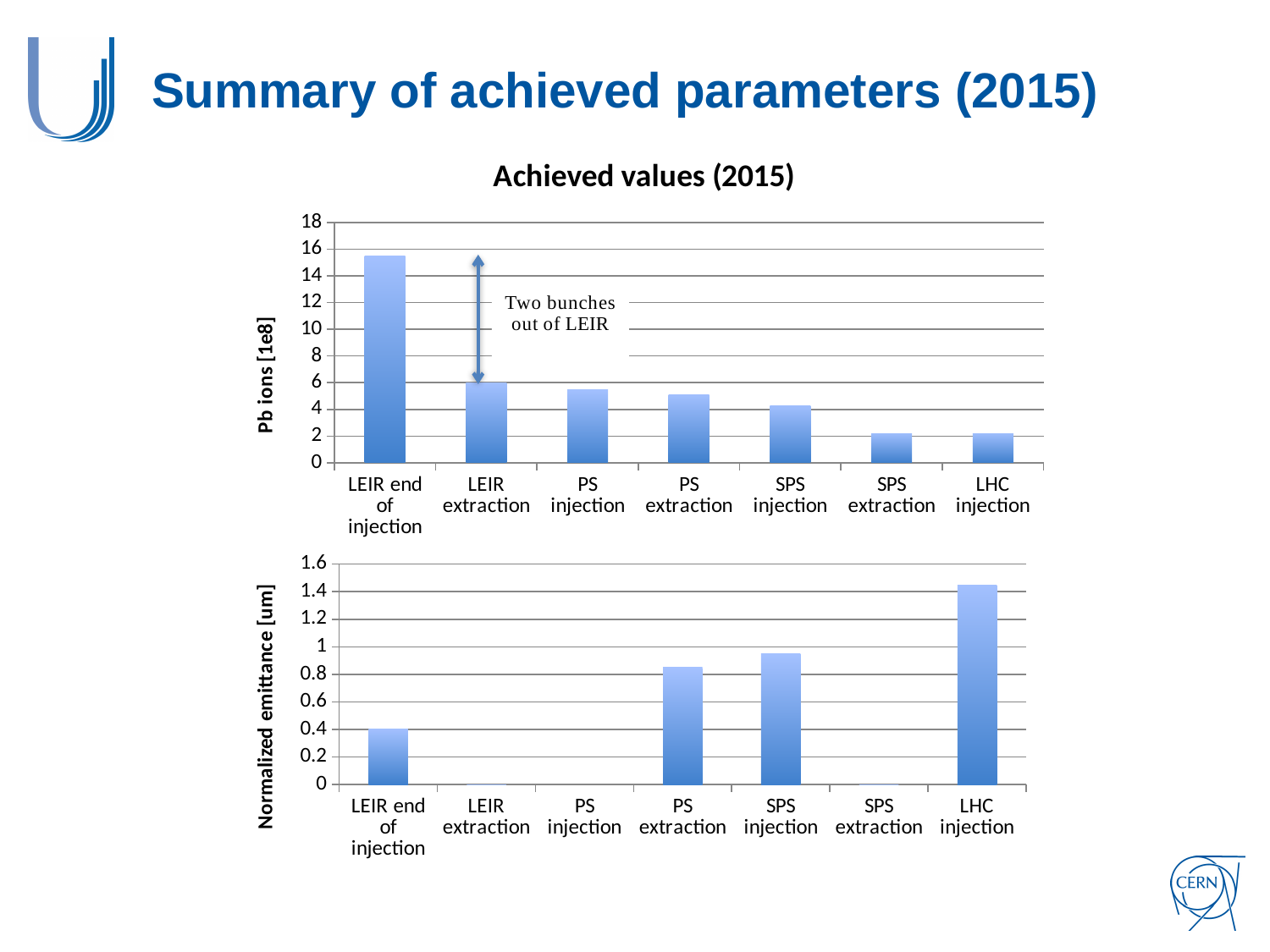
In the bottom chart (Normalized emittance), which category has the highest value? LHC injection In the bottom chart (Normalized emittance), which is larger, the value for SPS injection or the value for LEIR end of injection? SPS injection In the top chart (Pb ions), do the values generally rise or fall from left to right along the x axis? fall In the top chart (Pb ions), is the value for SPS injection greater or less than 6? less What is the y-axis label of the bottom chart? Normalized emittance [um] In the top chart (Pb ions), which is larger, the value for LEIR extraction or the value for SPS injection? LEIR extraction In the bottom chart (Normalized emittance), is the value for LHC injection greater or less than 1.2? greater In the top chart (Pb ions), which category has the highest value? LEIR end of injection In the top chart (Pb ions), how many categories are shown on the x axis? 7 What is the y-axis label of the top chart? Pb ions [1e8] In the top chart (Pb ions), is the value for LEIR end of injection greater or less than 14? greater What kind of chart is the top chart titled 'Achieved values (2015)'? bar chart